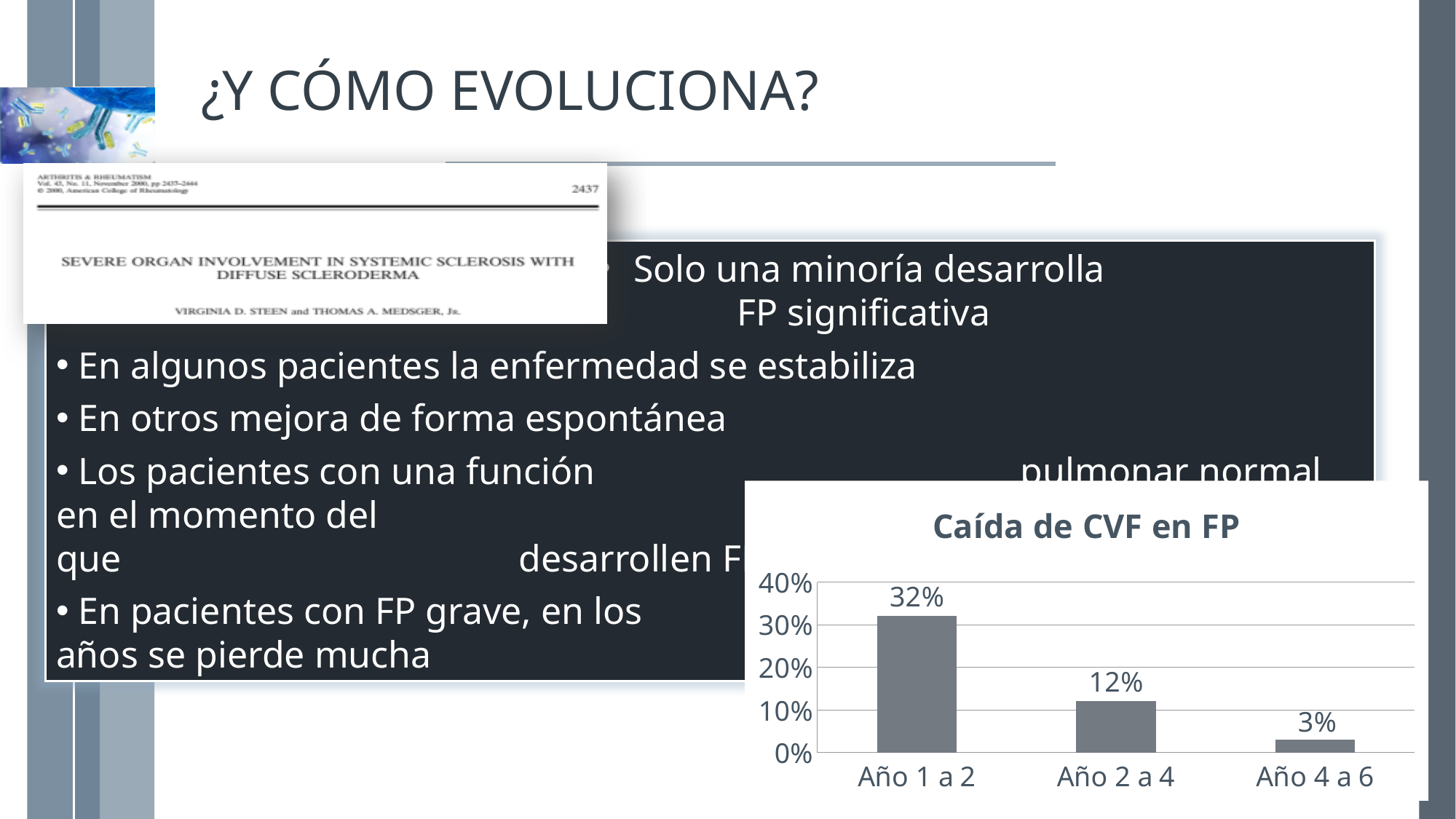
How many categories are shown in the chart? 3 What is the difference between the values for Año 1 a 2 and Año 2 a 4? 20% Is the value for Año 1 a 2 greater or less than 20%? greater What kind of chart is shown on the slide? bar chart What is the value for Año 1 a 2 in the chart? 32% What is the value for Año 2 a 4 in the chart? 12% Which is larger, the value for Año 2 a 4 or the value for Año 4 a 6? Año 2 a 4 What is the difference between the values for Año 2 a 4 and Año 4 a 6? 9% Which category has the lowest value in the chart? Año 4 a 6 Do the values rise or fall from Año 1 a 2 to Año 4 a 6? fall Which category has the highest value in the chart? Año 1 a 2 What is the value for Año 4 a 6 in the chart? 3%